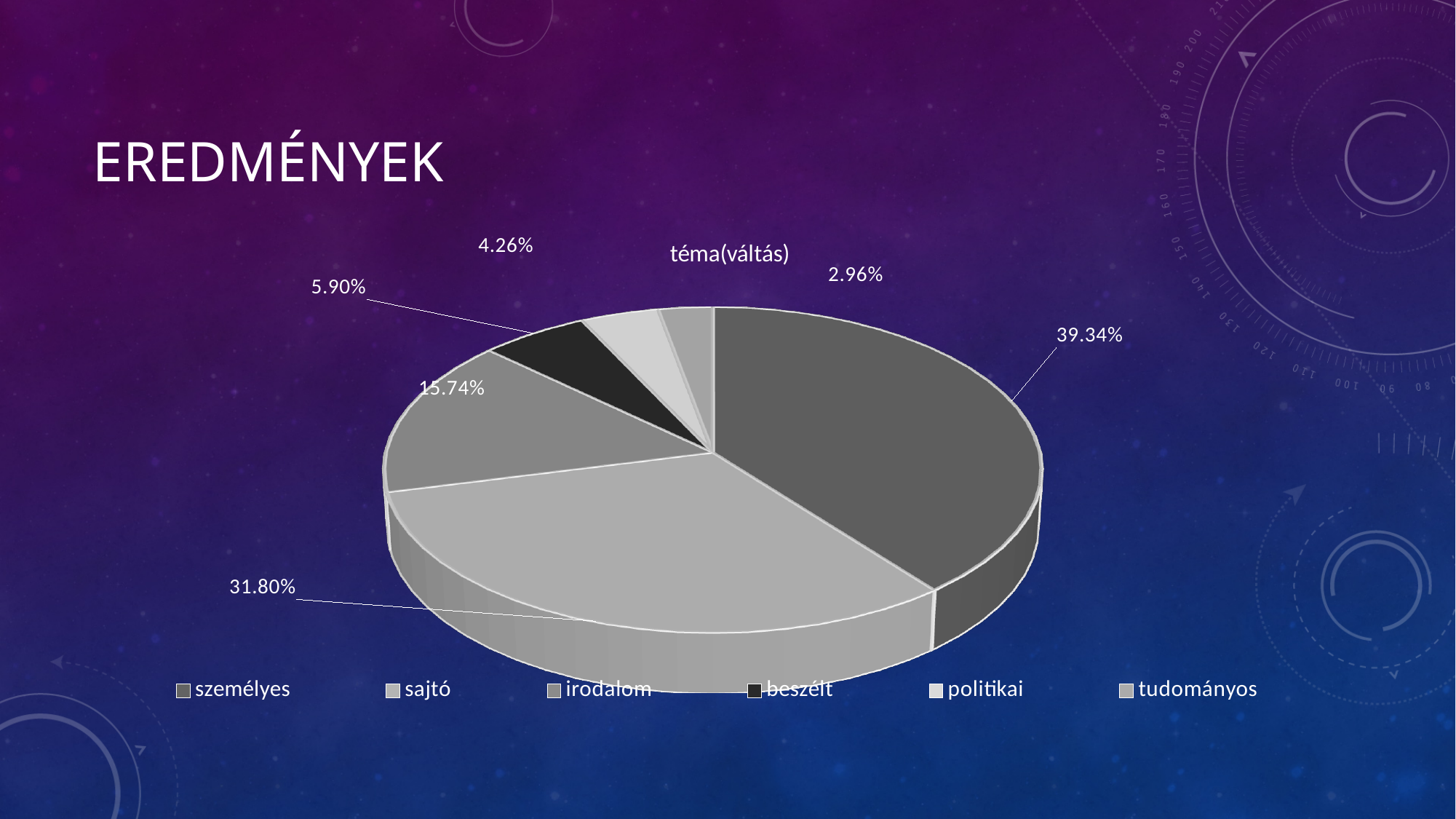
What is the value shown for 'tudományos'? 2.96% What share of the pie does the 'személyes' slice have? 39.34% How many categories does the legend of the pie chart list? 6 What share of the pie does the 'sajtó' slice have? 31.80% Which category has the smallest slice of the pie? tudományos Which is larger, the 'politikai' slice or the 'beszélt' slice? beszélt What is the value shown for 'beszélt'? 5.90% Which category has the largest slice of the pie? személyes What is the difference between the 'személyes' and 'sajtó' shares? 7.54% What is the title of the chart? téma(váltás) What is the value shown for 'irodalom'? 15.74% What kind of chart is shown on the slide? pie chart